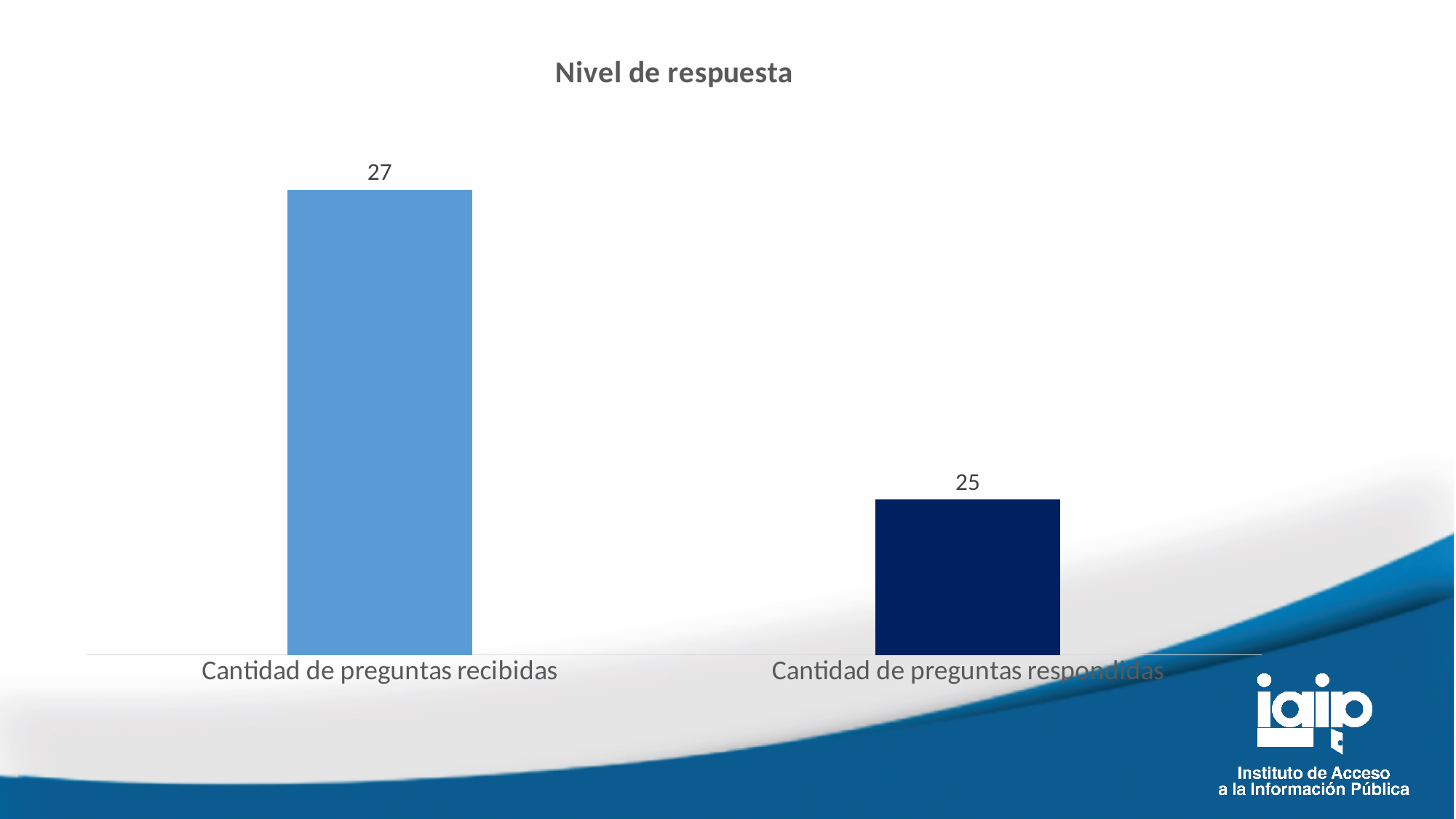
Which category has the highest value? Cantidad de preguntas recibidas What kind of chart is shown on the slide? Bar chart Which is larger: the value for "Cantidad de preguntas recibidas" or the value for "Cantidad de preguntas respondidas"? Cantidad de preguntas recibidas What is the value for "Cantidad de preguntas respondidas"? 25 What is the value for "Cantidad de preguntas recibidas"? 27 Do the values rise or fall from left to right across the categories? Fall What is the title of the chart? Nivel de respuesta What is the difference between the value for "Cantidad de preguntas recibidas" and the value for "Cantidad de preguntas respondidas"? 2 Which category has the lowest value? Cantidad de preguntas respondidas What colour is the bar for "Cantidad de preguntas respondidas"? Dark navy blue How many categories are shown in the chart? 2